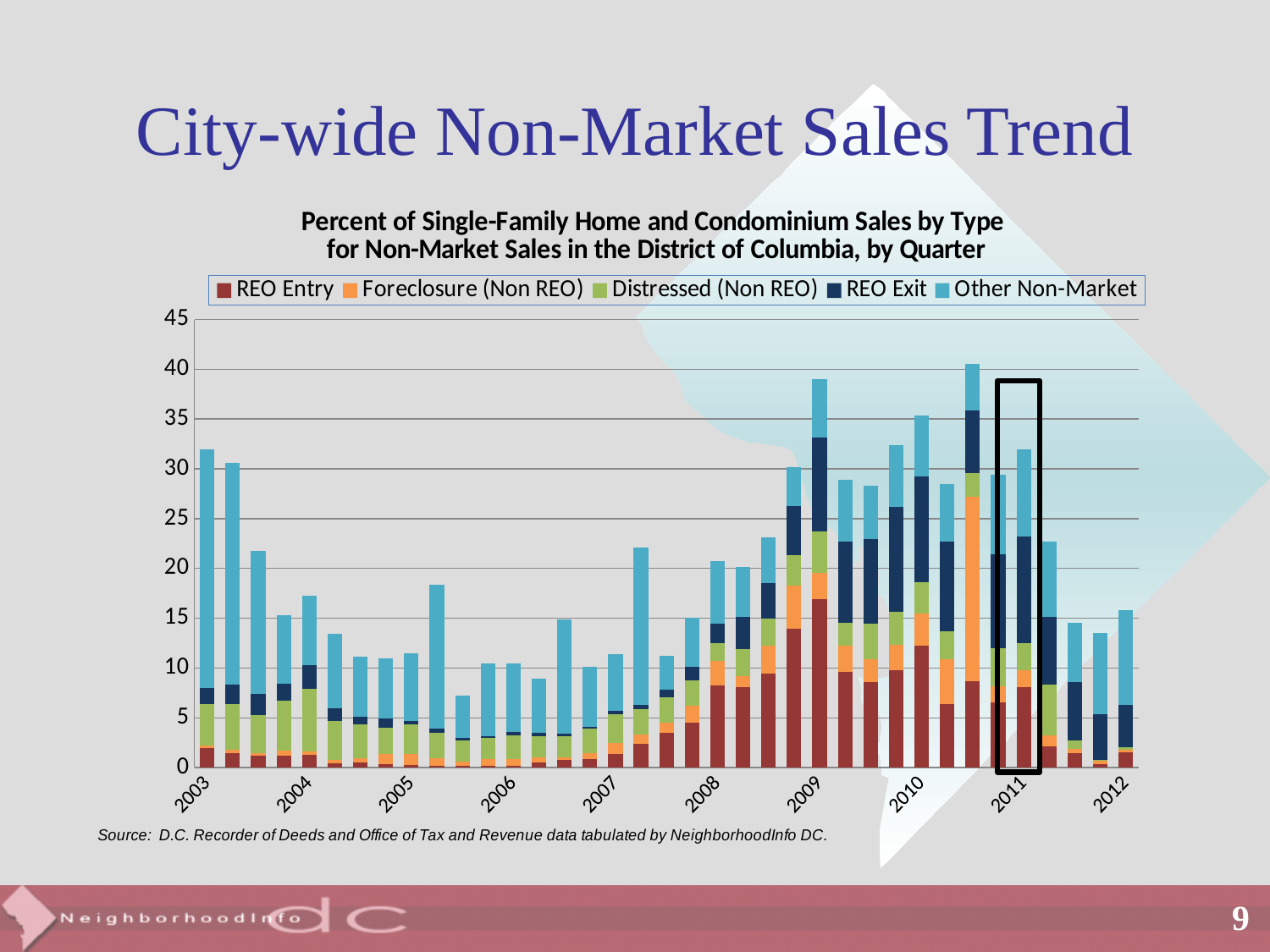
How many series does the legend list? 5 Is the total for the bar at the 2009 label greater or less than 35? greater Do the bar totals generally rise or fall from the 2006 label to the 2009 label? rise How many year labels appear along the x axis? 10 Is the total for the bar at the 2006 label greater or less than 15? less Which series is listed first in the legend? REO Entry What is the highest value shown on the vertical axis? 45 Do the bar totals generally rise or fall from the 2003 label to the 2006 label? fall Which is larger, the total for the bar at the 2003 label or the total for the bar at the 2006 label? 2003 Is the total for the bar at the 2012 label greater or less than 20? less What kind of chart is shown on the slide? Stacked bar chart